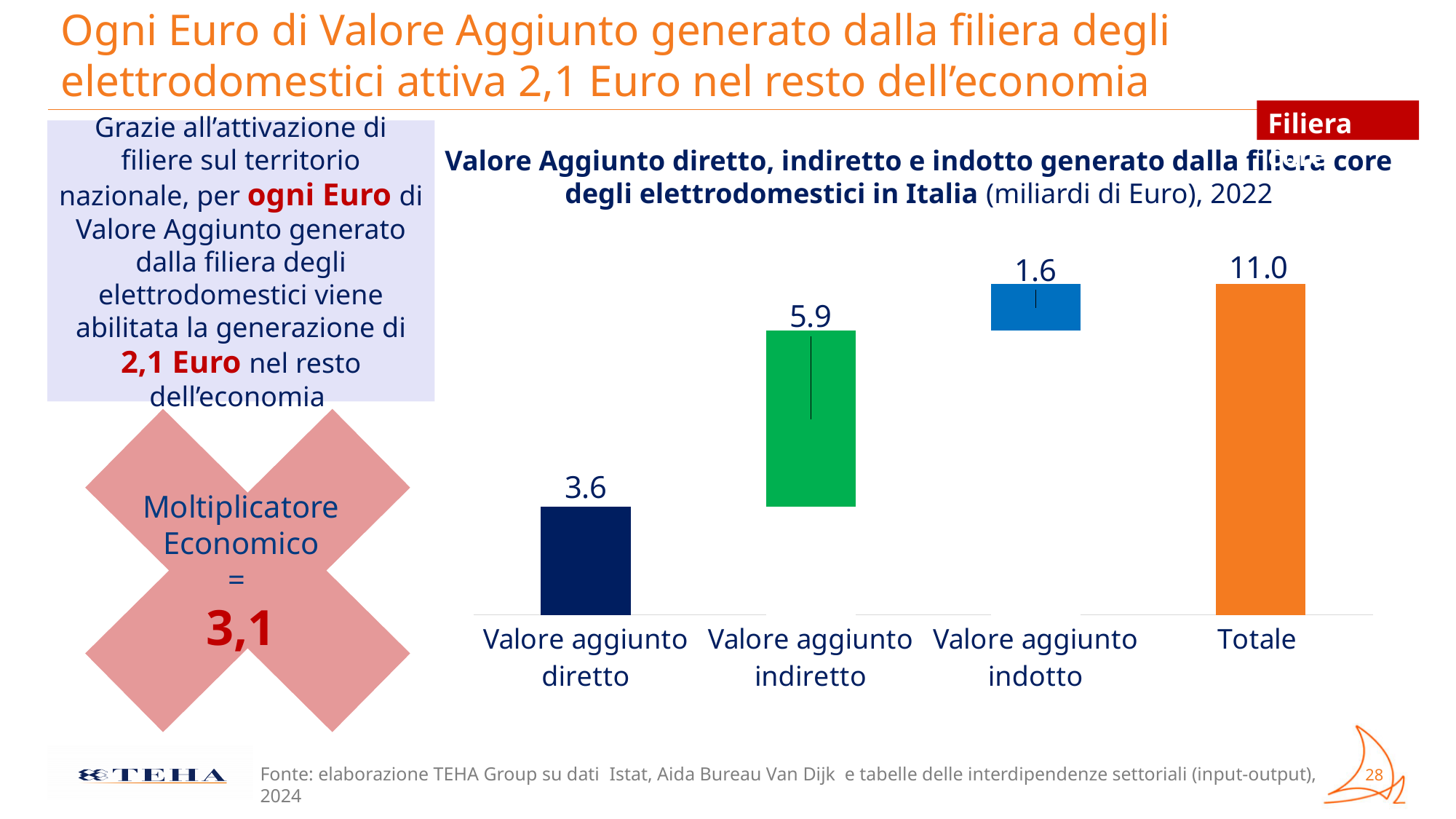
Which category has the highest value? Totale Which is larger, Valore aggiunto diretto or Valore aggiunto indotto? Valore aggiunto diretto Which category has the lowest value? Valore aggiunto indotto What is the value for Totale? 11.0 What is the difference between Valore aggiunto indiretto and Valore aggiunto diretto? 2.3 What unit is stated in the chart title? miliardi di Euro What year does the chart refer to? 2022 What is the value for Valore aggiunto indotto? 1.6 How many categories are shown on the x axis? 4 What is the value for Valore aggiunto indiretto? 5.9 What kind of chart is this? Bar chart What is the value for Valore aggiunto diretto? 3.6